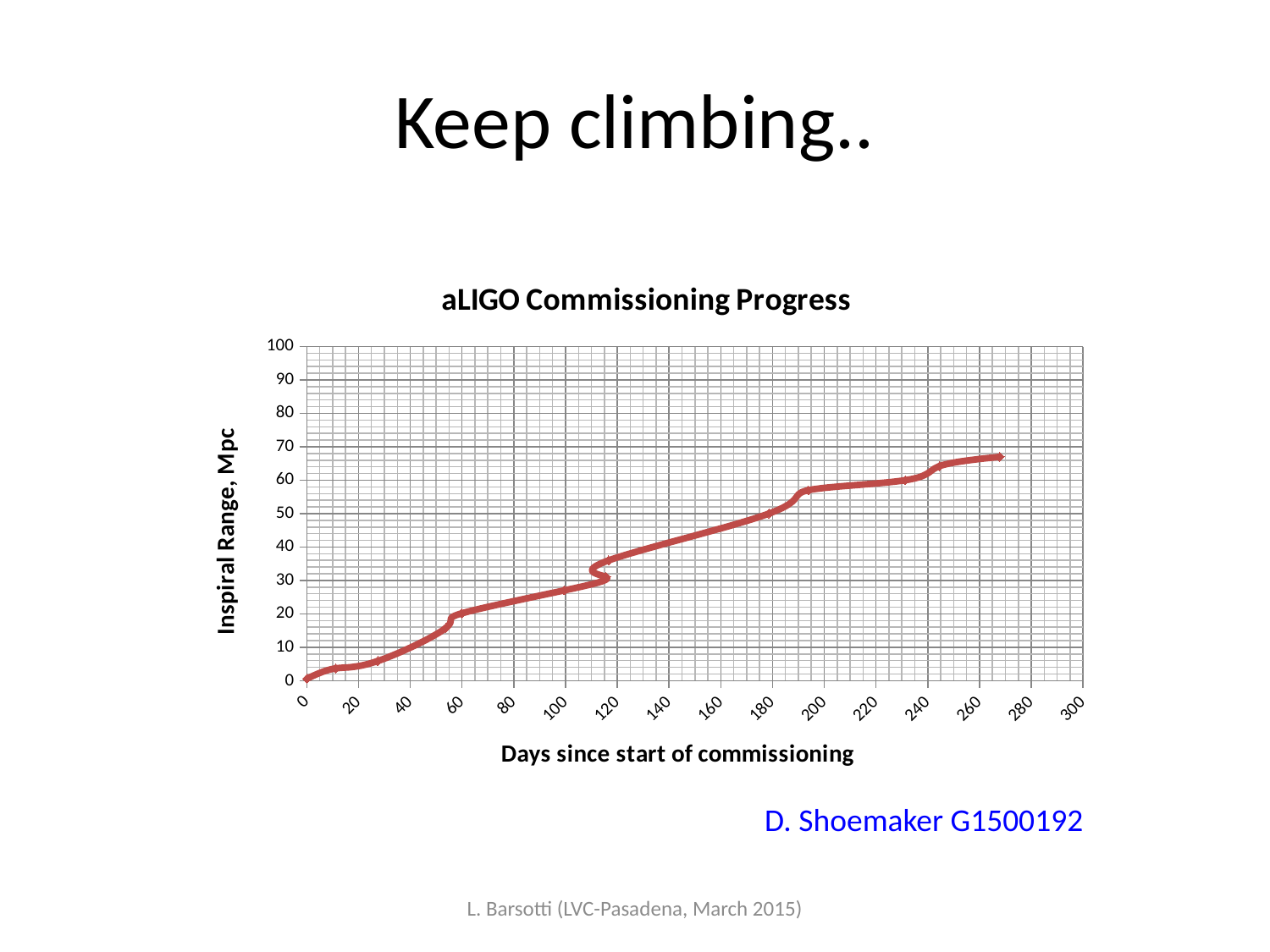
Is the inspiral range at day 120 greater or less than 30? greater What is the label of the y axis? Inspiral Range, Mpc Is the inspiral range at day 120 greater or less than 40? less What is the title of the chart? aLIGO Commissioning Progress Is the inspiral range at day 20 greater or less than 10? less What kind of chart is shown on the slide? line chart Do the values rise or fall as the days since start of commissioning increase? rise Is the inspiral range higher at day 200 or at day 100? day 200